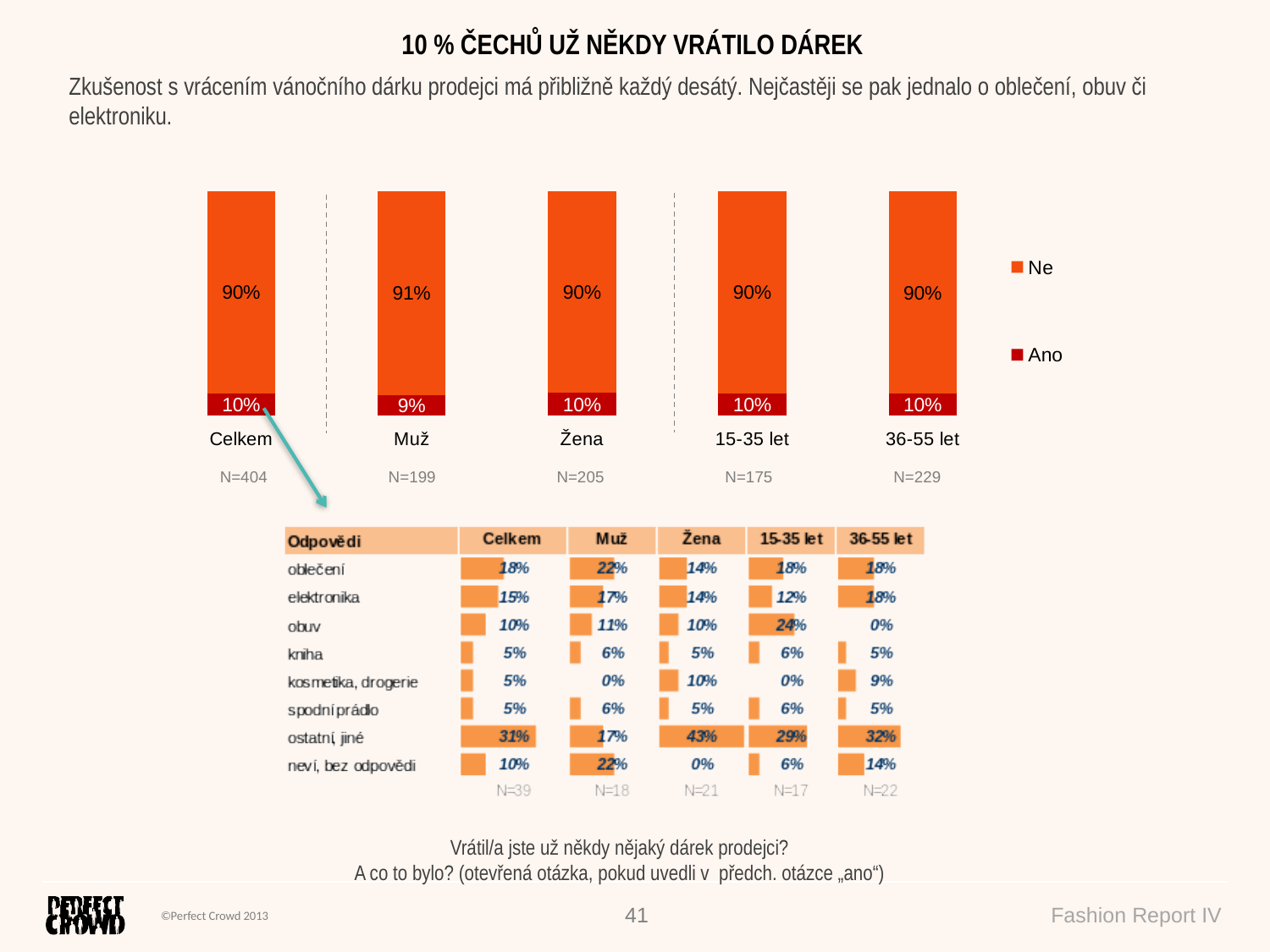
In the stacked bar chart, which category has the highest "Ne" value? Muž In the stacked bar chart, which category has the lowest "Ano" value? Muž In the stacked bar chart, is the "Ano" value for Žena larger or smaller than the "Ano" value for Muž? larger In the stacked bar chart, what is the value of "Ano" for Muž? 9% In the stacked bar chart, what is the difference between the "Ano" values for Celkem and Muž? 1% In the stacked bar chart, what is the value of "Ne" for Celkem? 90% What type of chart is the upper chart on the slide? stacked bar chart In the stacked bar chart, what is the value of "Ne" for Muž? 91% How many series does the legend of the stacked bar chart list? 2 In the stacked bar chart, what is the total of the Celkem bar (Ne plus Ano)? 100% How many categories are shown in the stacked bar chart? 5 In the stacked bar chart, what is the value of "Ano" for 36-55 let? 10%